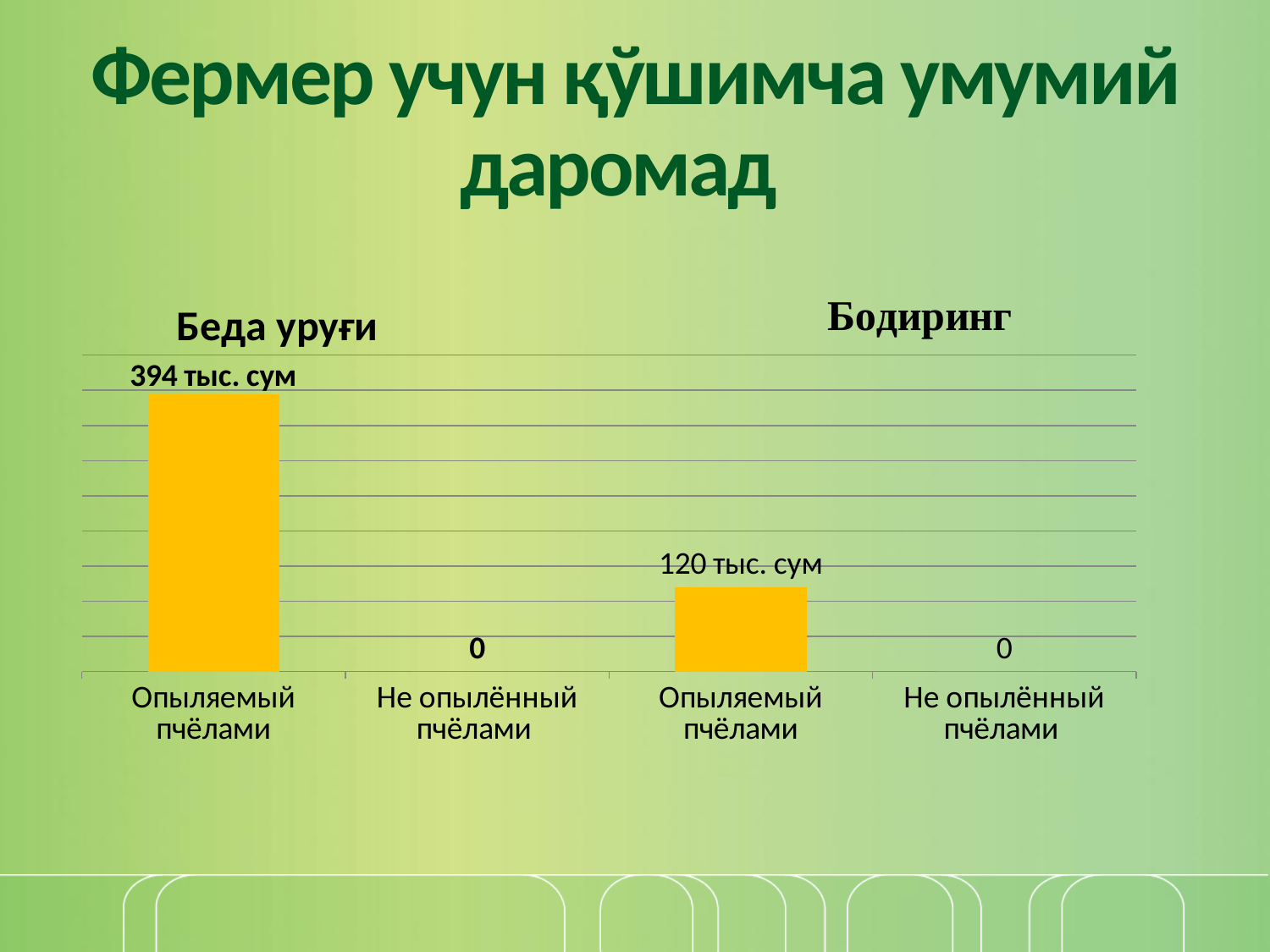
Which bar has the highest value on the chart? Опыляемый пчёлами (Беда уруғи) What is the total of the two "Опыляемый пчёлами" values across both groups? 514 тыс. сум What is the value for "Опыляемый пчёлами" in the "Беда уруғи" group? 394 тыс. сум What is the title of the slide? Фермер учун қўшимча умумий даромад Which is larger: the "Опыляемый пчёлами" value for "Беда уруғи" or for "Бодиринг"? Беда уруғи What is the value for "Не опылённый пчёлами" in the "Беда уруғи" group? 0 What is the value for "Опыляемый пчёлами" in the "Бодиринг" group? 120 тыс. сум What is the difference between the "Опыляемый пчёлами" values for "Беда уруғи" and "Бодиринг"? 274 тыс. сум What kind of chart is shown on the slide? Bar chart What is the value for "Не опылённый пчёлами" in the "Бодиринг" group? 0 How many bars (categories) are plotted on the chart? 4 What are the two group labels shown above the chart? Беда уруғи and Бодиринг